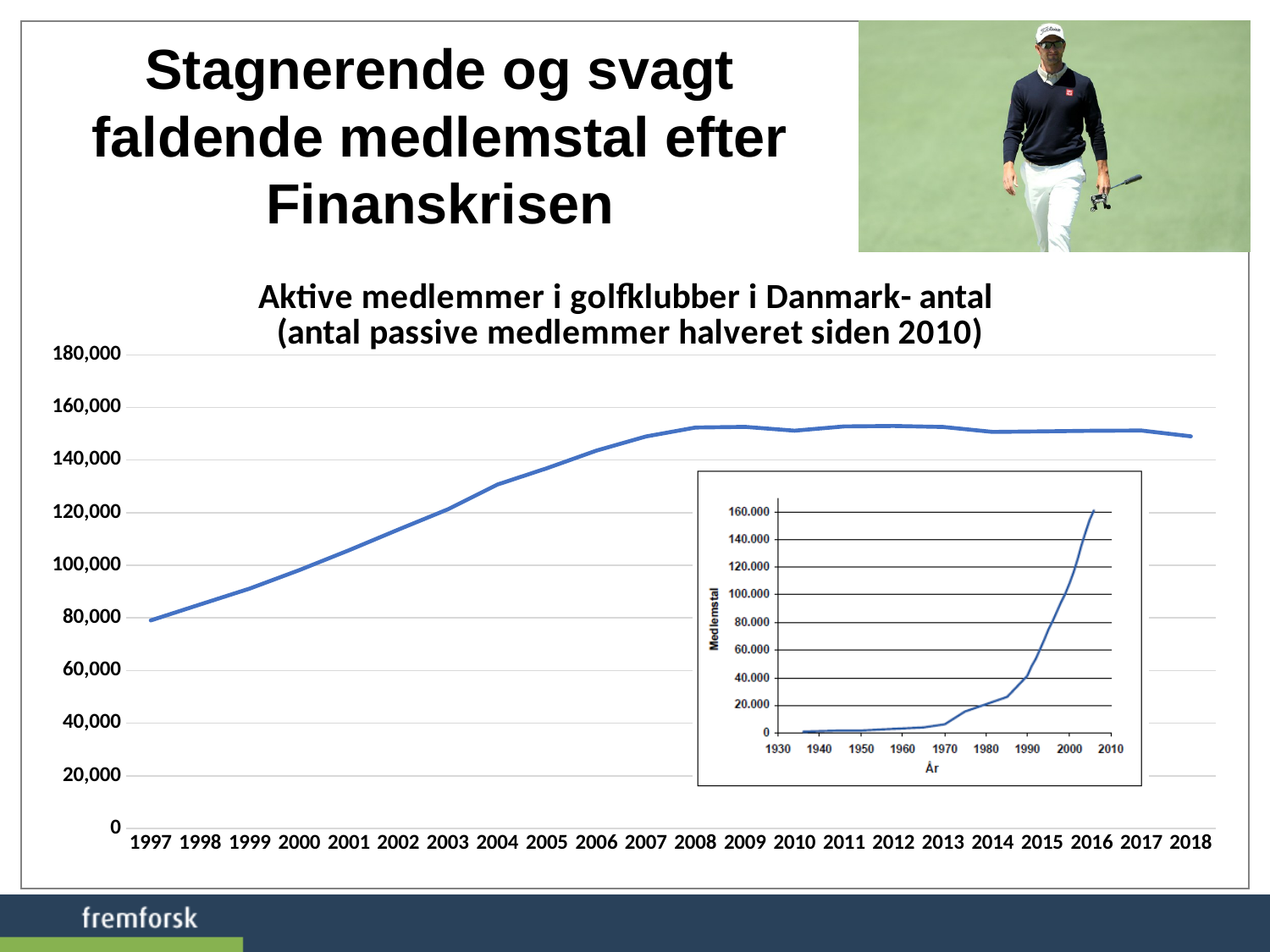
In the main chart, do the values rise or fall from 1997 to 2008? rise In the main chart, is the value for 2018 greater or less than 160,000? less What is the label on the vertical axis of the inset chart in the lower right? Medlemstal What kind of chart is the main chart titled 'Aktive medlemmer i golfklubber i Danmark- antal'? line chart In the main chart, which year has the larger value, 1999 or 2007? 2007 In the main chart, is the value for 2008 greater or less than 140,000? greater In the main chart, is the value for 2001 greater or less than 100,000? greater In the main chart, how many years are shown on the x axis? 22 In the main chart, which year has the lowest number of active members? 1997 In the inset chart in the lower right, do the values rise or fall from 1980 to 2010? rise